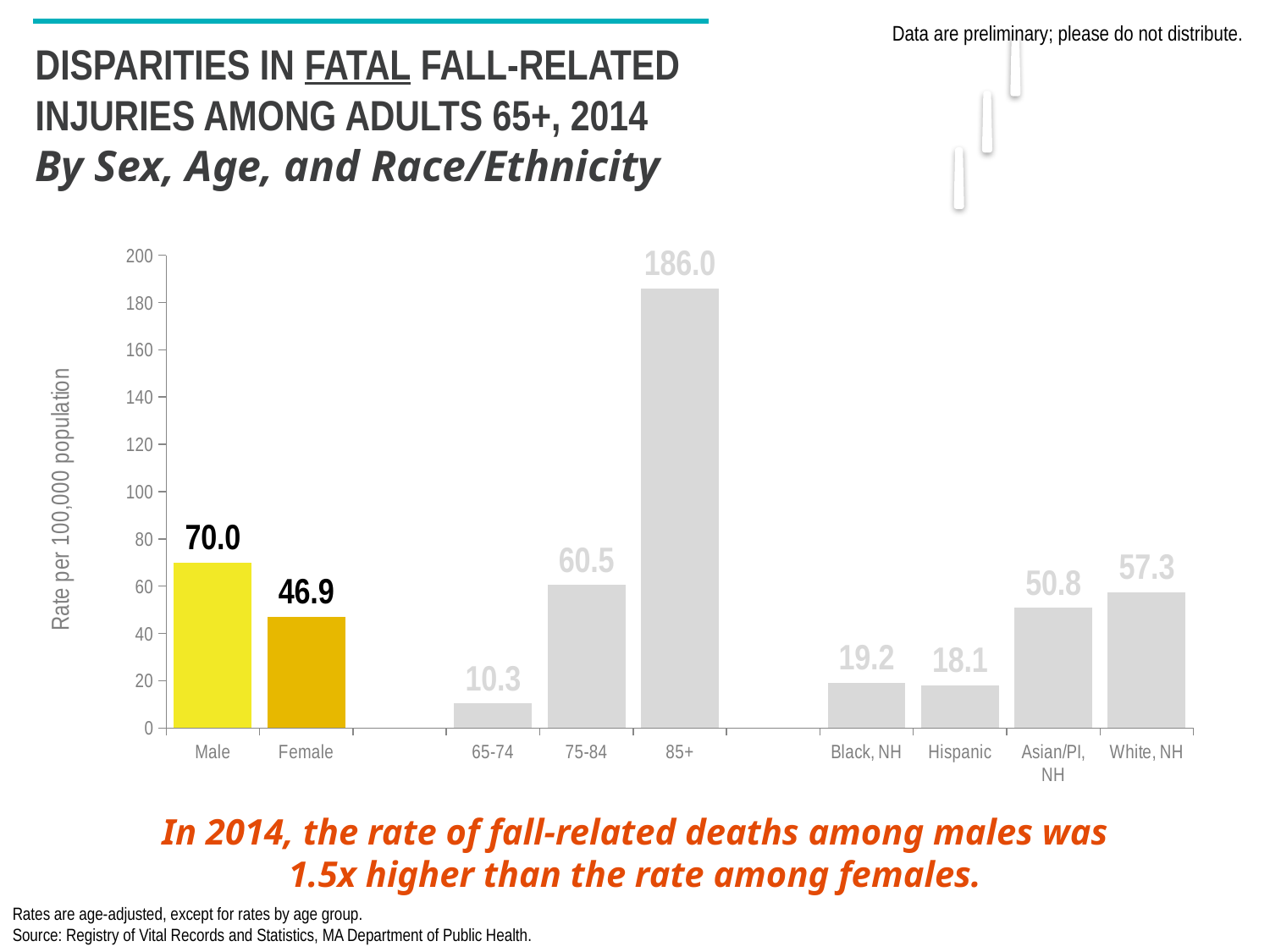
What is the rate for the 85+ age group? 186.0 What kind of chart is shown on the slide? bar chart Which category has the highest rate on the chart? 85+ What is the label of the y axis? Rate per 100,000 population What is the fatal fall-related injury rate for females? 46.9 Which has a higher rate, White, NH or Asian/PI, NH? White, NH What is the difference between the male and female rates? 23.1 Which category has the lowest rate on the chart? 65-74 How many categories are plotted on the chart? 9 What is the fatal fall-related injury rate for males? 70.0 What is the rate for Hispanic adults? 18.1 Is the rate for the 75-84 age group greater or less than 80? less